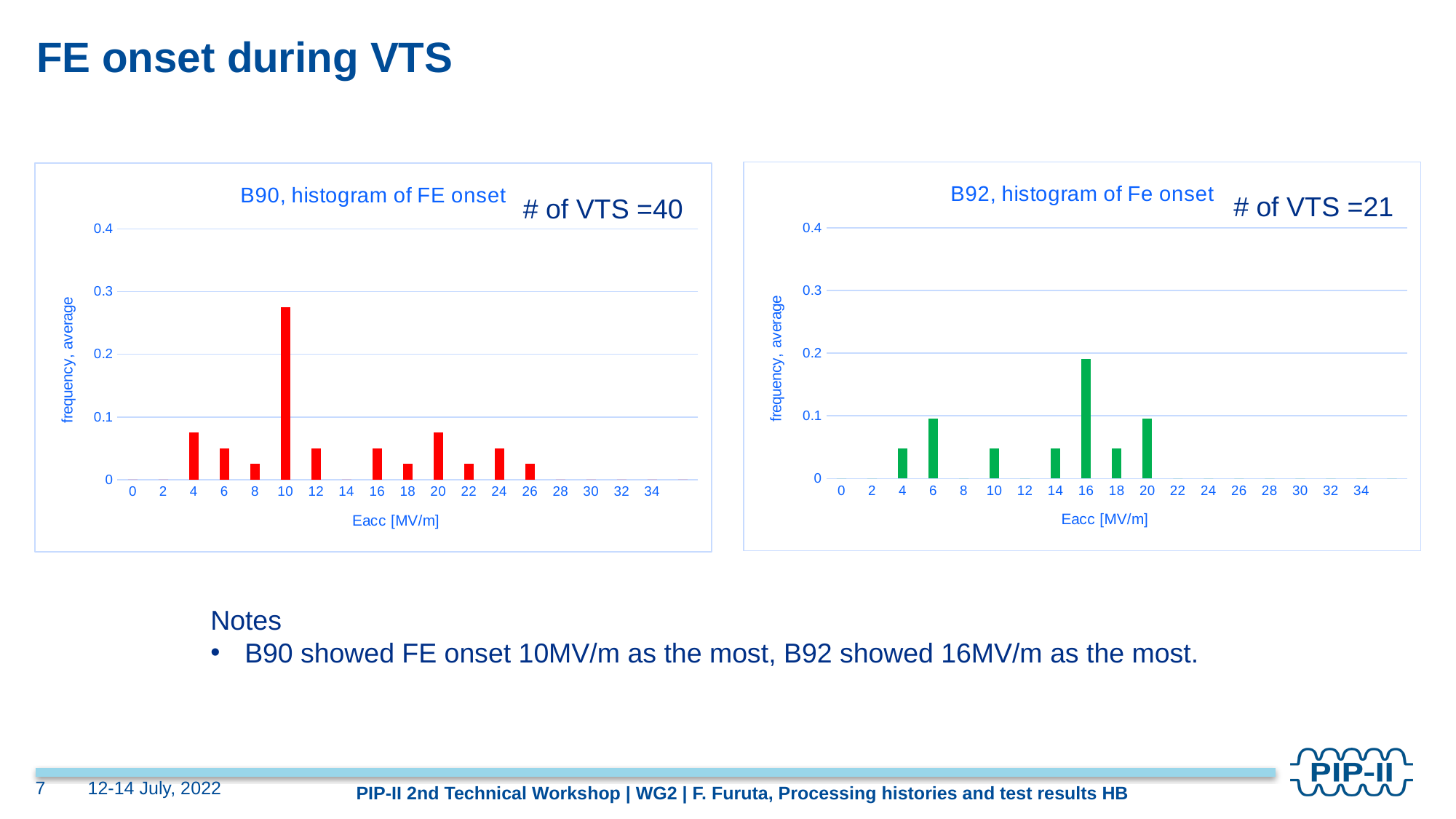
How many non-zero bars are plotted in the B90 histogram of FE onset chart? 11 What type of chart is the B92 histogram of Fe onset chart? Bar chart In the B90 histogram of FE onset chart, is the frequency at Eacc 4 MV/m greater or less than 0.1? less In the B92 histogram of Fe onset chart, is the frequency at Eacc 16 MV/m greater or less than 0.1? greater In the B92 histogram of Fe onset chart, which Eacc value has the highest frequency? 16 How many non-zero bars are plotted in the B92 histogram of Fe onset chart? 7 In the B92 histogram of Fe onset chart, is the frequency at Eacc 20 MV/m greater or less than 0.2? less In the B90 histogram of FE onset chart, which Eacc value has the highest frequency? 10 What is the y-axis label of the B90 histogram of FE onset chart? frequency, average In the B90 histogram of FE onset chart, which has the higher frequency: Eacc 10 MV/m or Eacc 20 MV/m? 10 MV/m In the B92 histogram of Fe onset chart, which has the higher frequency: Eacc 4 MV/m or Eacc 6 MV/m? 6 MV/m